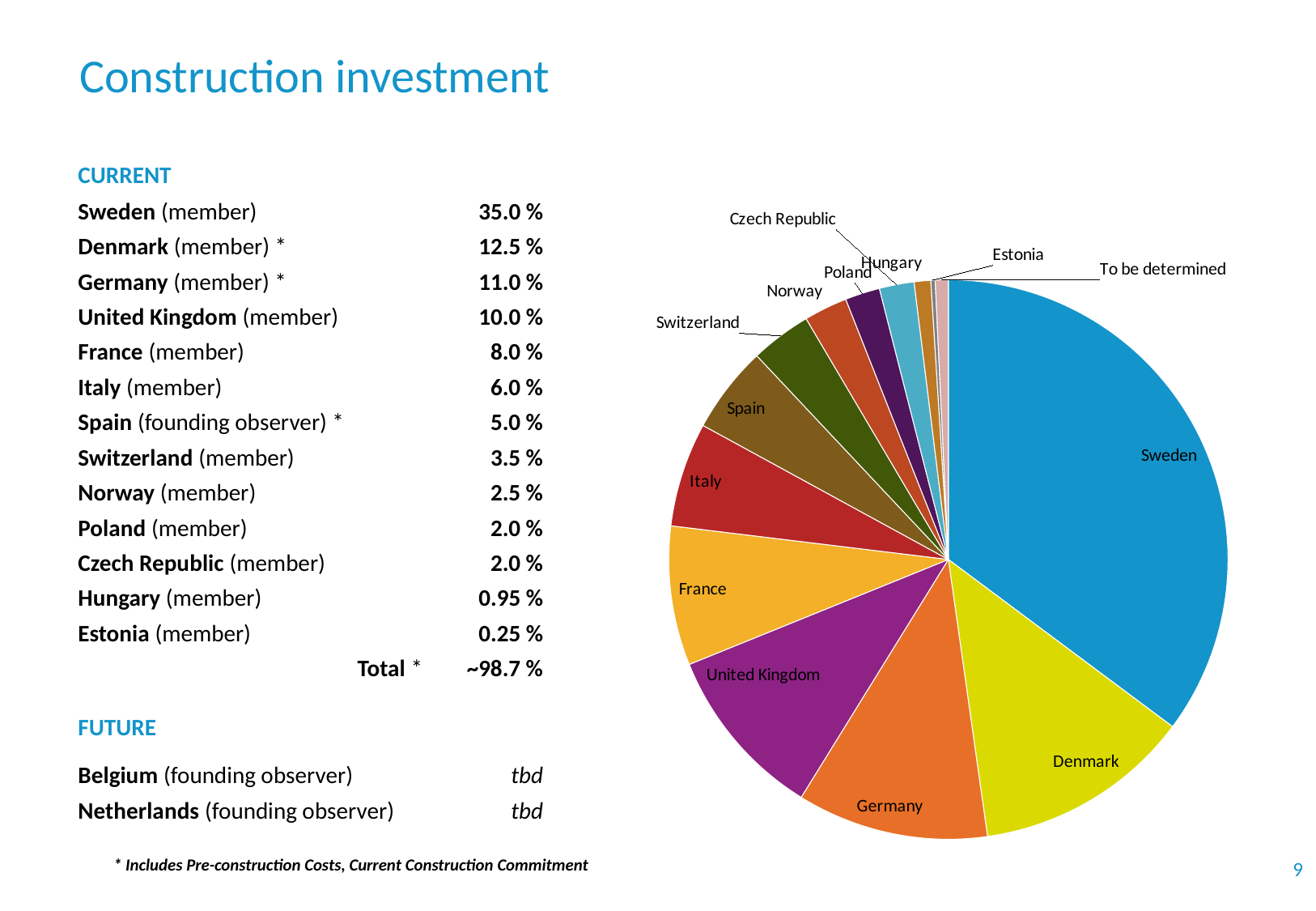
What share of construction investment does Sweden hold? 35.0 % What is the title of the slide containing the pie chart? Construction investment How many slices does the pie chart have? 14 Which slice of the pie chart is the largest? Sweden Which slice of the pie chart is labelled with a status rather than a country name? To be determined What kind of chart is shown on the slide? pie chart What is the difference between France's share and Italy's share? 2.0 % What is the difference between Sweden's share and Denmark's share? 22.5 % What share of construction investment does Denmark hold? 12.5 % Which is larger in the pie chart, the Italy slice or the Spain slice? Italy What share of construction investment does Estonia hold? 0.25 % Which is larger in the pie chart, the Germany slice or the United Kingdom slice? Germany